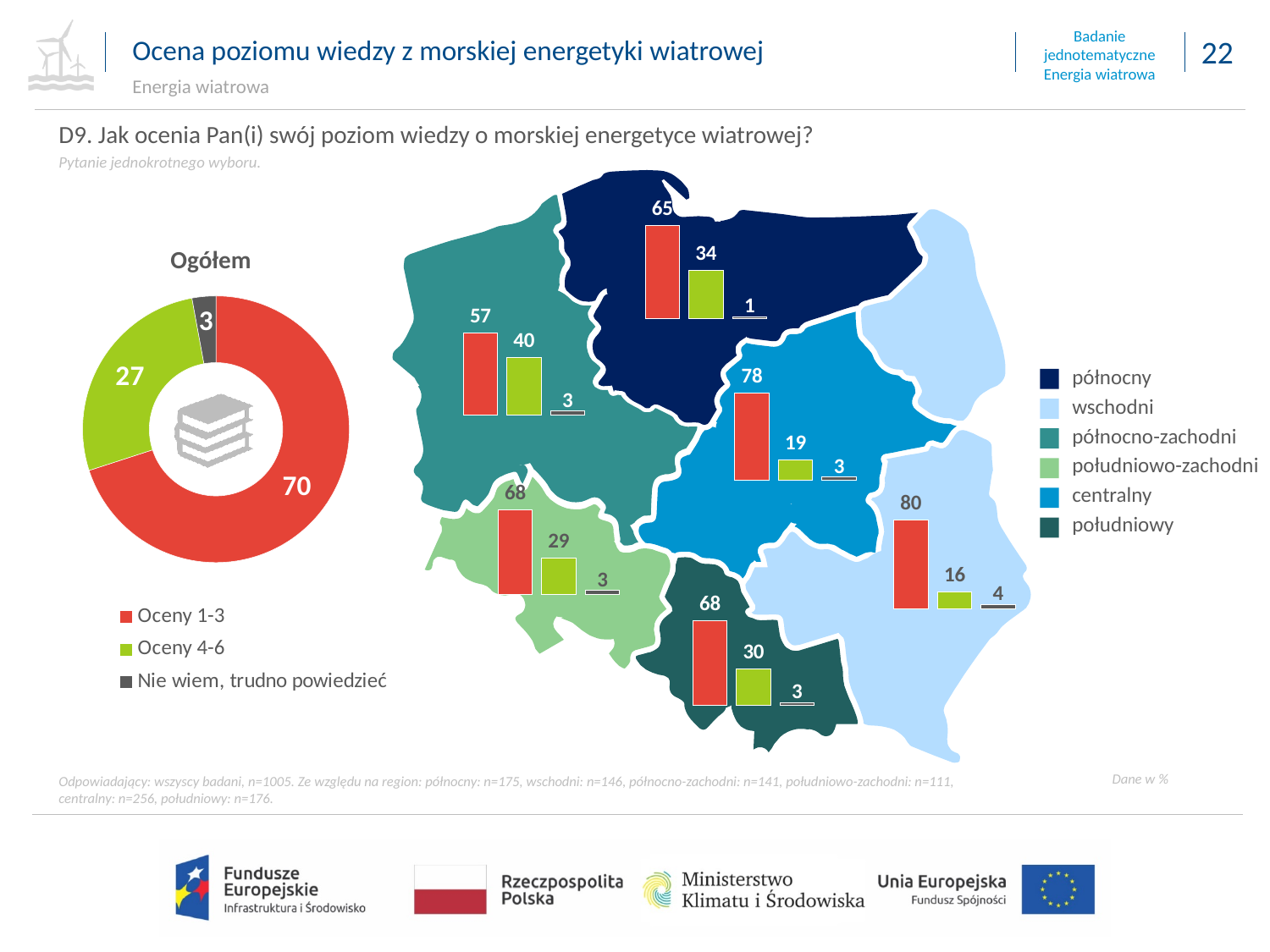
On the map, which region has the lowest value for 'Oceny 1-3'? północno-zachodni On the map, which region has the highest value for 'Oceny 1-3'? wschodni In the 'Ogółem' donut chart, which category has the largest share? Oceny 1-3 How many categories does the legend of the 'Ogółem' chart list? 3 In the 'Ogółem' donut chart, what is the difference between 'Oceny 1-3' and 'Oceny 4-6'? 43 On the map, is the 'Oceny 1-3' value larger for the 'centralny' region or the 'północny' region? centralny On the map, what is the value of the green bar ('Oceny 4-6') for the 'północno-zachodni' region? 40 In the 'Ogółem' donut chart, what is the value for 'Nie wiem, trudno powiedzieć'? 3 In the 'Ogółem' donut chart, what is the value for 'Oceny 1-3'? 70 What kind of chart is the 'Ogółem' chart on the left of the slide? Donut (pie) chart On the map, what is the value of the red bar ('Oceny 1-3') for the 'wschodni' region? 80 How many regions does the map legend list? 6